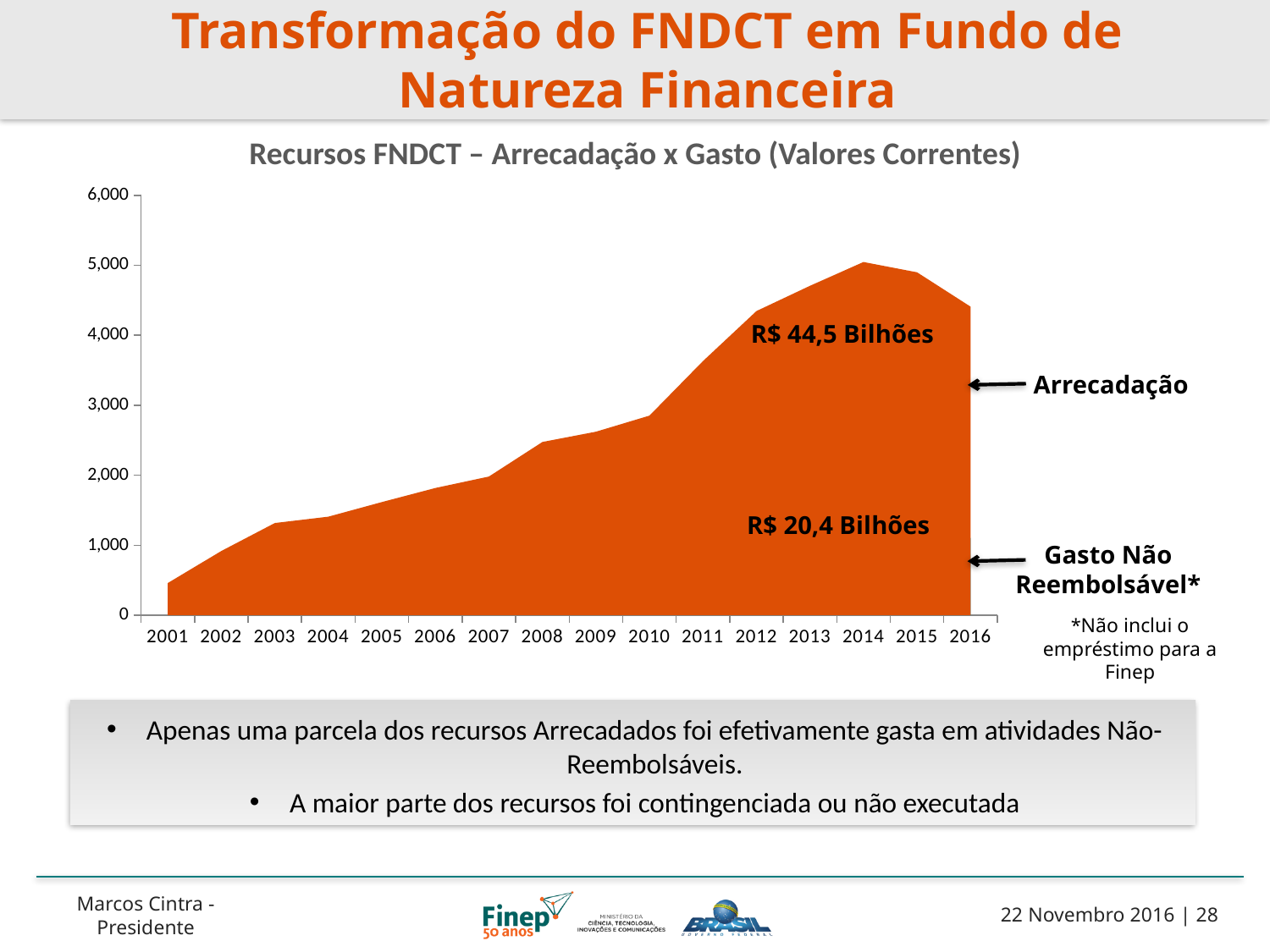
Is the value for 2001 greater or less than 1,000? less What kind of chart is shown on the slide? Area chart What is the title of the chart? Recursos FNDCT – Arrecadação x Gasto (Valores Correntes) What total amount is annotated on the chart for Gasto Não Reembolsável? R$ 20,4 Bilhões In which year is the Arrecadação value lowest? 2001 Is the value for 2008 greater or less than 2,000? greater How many years are shown on the x axis of the chart? 16 Do the values rise or fall from 2001 to 2014? rise What total amount is annotated on the chart for Arrecadação? R$ 44,5 Bilhões Is the value for 2014 greater or less than 4,000? greater In which year does the Arrecadação area reach its highest point? 2014 Which year has the larger value, 2014 or 2016? 2014